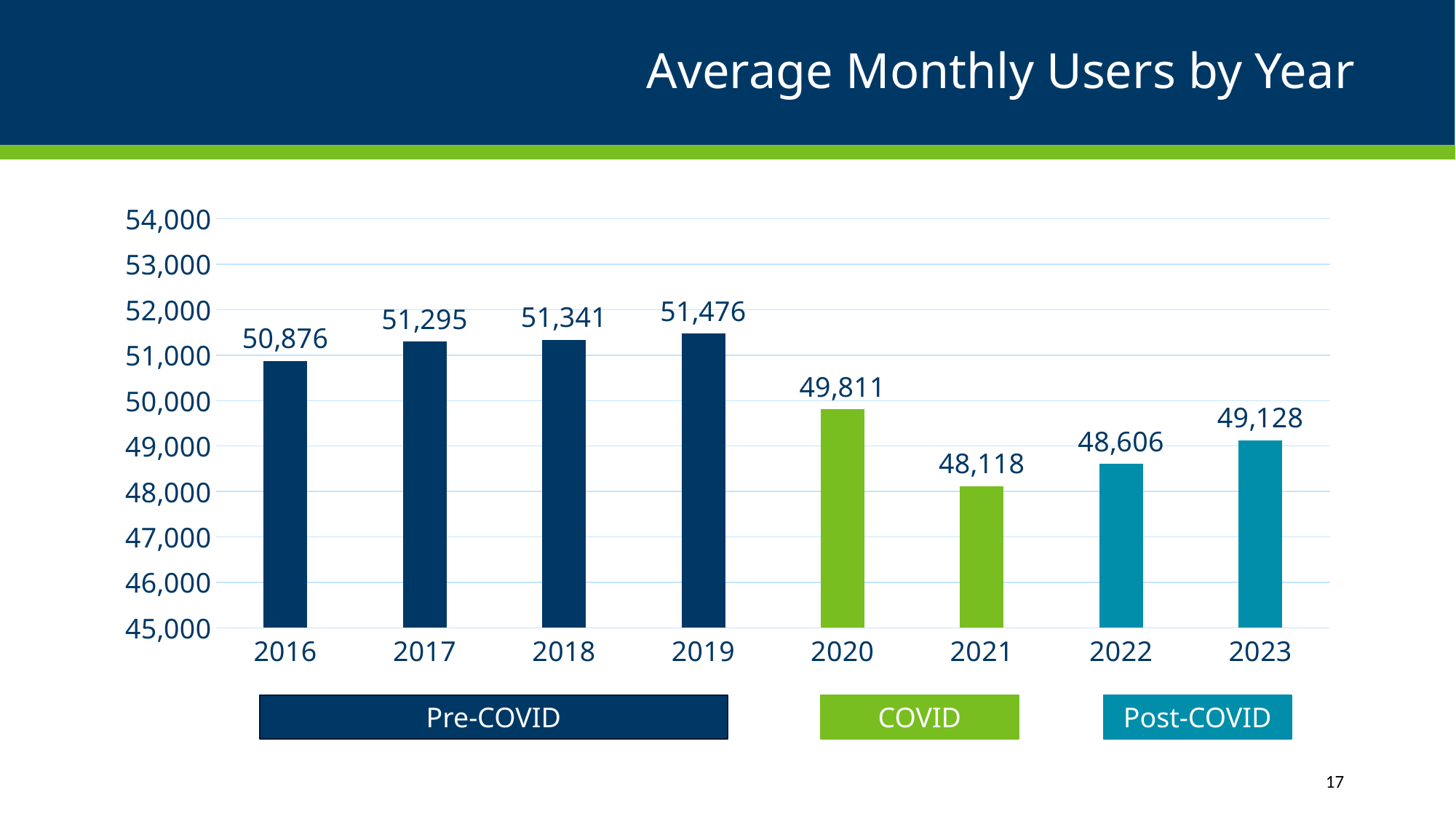
What was the average monthly users value for 2023? 49,128 Which year had the lowest average monthly users? 2021 What is the difference in average monthly users between 2019 and 2021? 3,358 What type of chart is shown on the slide? bar chart Which year had the highest average monthly users? 2019 Which year had more average monthly users, 2020 or 2022? 2020 Which period label is shown for the years 2020 and 2021? COVID What was the average monthly users value for 2021? 48,118 Is the value for 2020 greater or less than 50,000? less How many years are shown on the chart? 8 What was the average monthly users value for 2016? 50,876 What is the difference in average monthly users between 2023 and 2022? 522